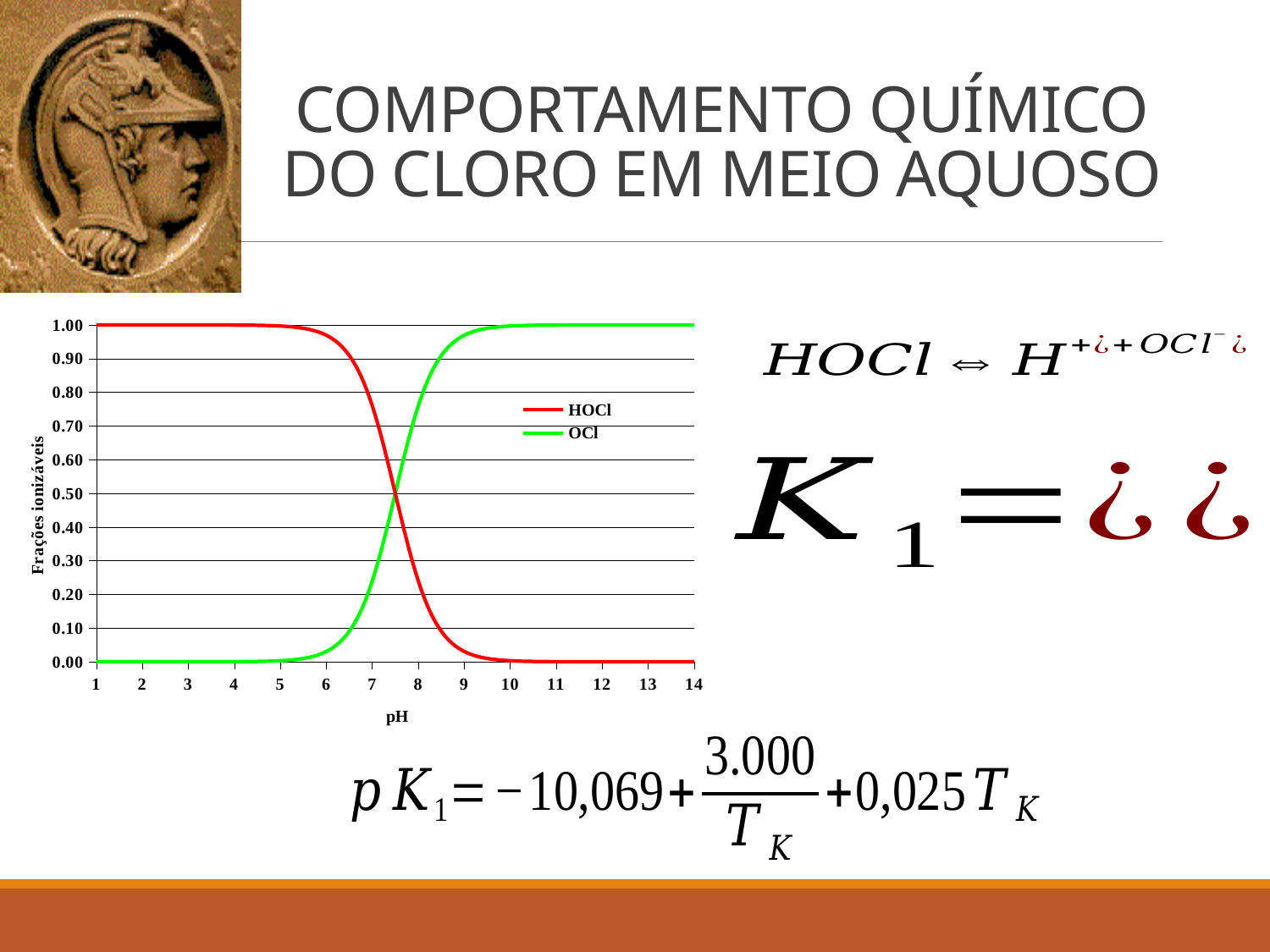
What is the label of the chart's x axis? pH Does the OCl series rise or fall as pH increases? rise Does the HOCl series rise or fall as pH increases? fall What are the two series named in the chart's legend? HOCl and OCl Is the value for HOCl at pH 5 greater or less than 0.90? greater How many pH values are marked along the chart's x axis? 14 How many series does the chart's legend list? 2 At pH 7, which series has the larger value, HOCl or OCl? HOCl At pH 9, which series has the larger value, HOCl or OCl? OCl Is the value for HOCl at pH 10 greater or less than 0.10? less What kind of chart is shown on the slide? line chart Is the value for OCl at pH 5 greater or less than 0.10? less